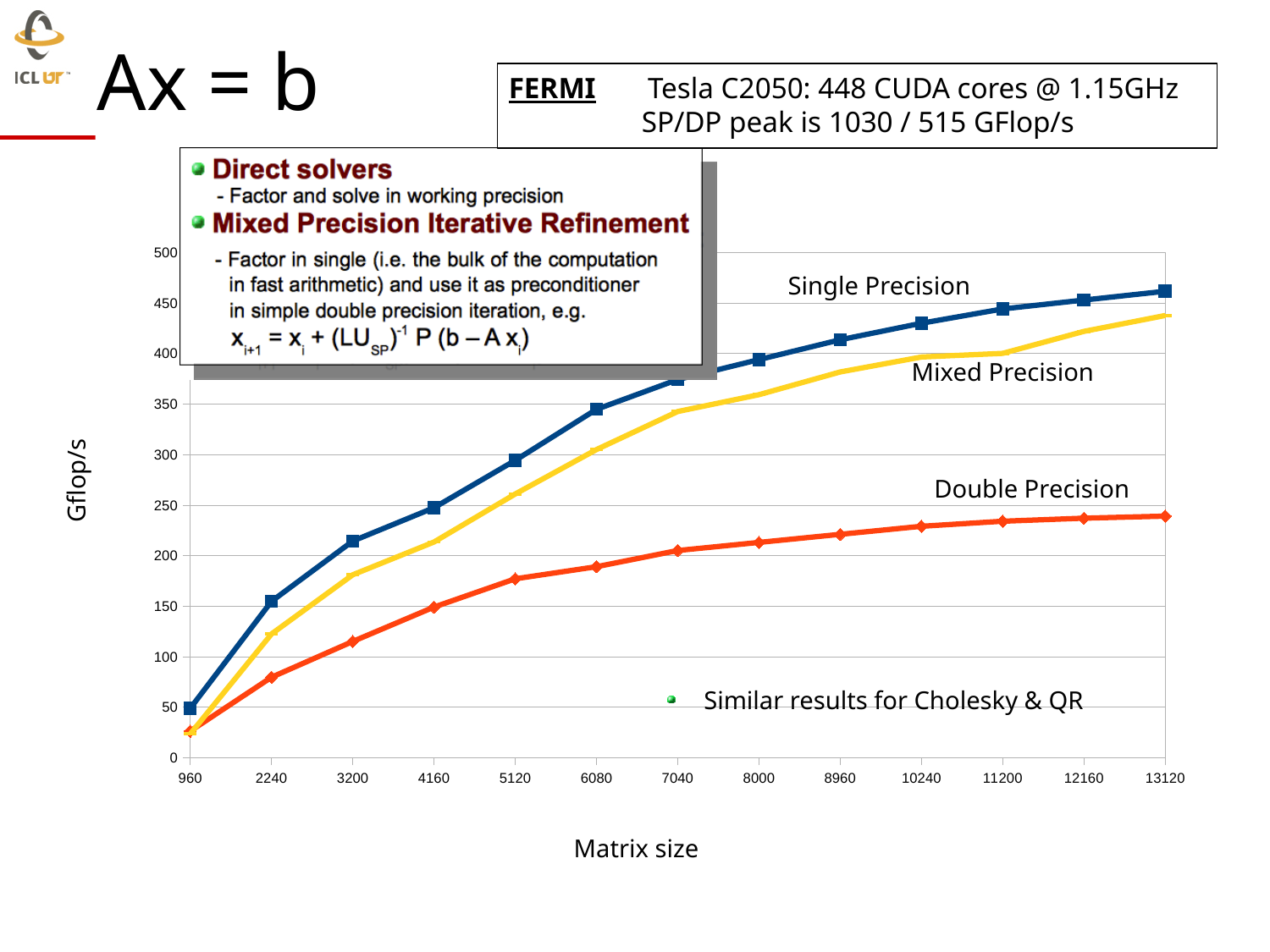
Which series has the lowest Gflop/s at matrix size 13120? Double Precision At matrix size 3200, which is larger: Single Precision or Mixed Precision? Single Precision Is the Single Precision value at matrix size 960 greater or less than 100? less What kind of chart is shown on the slide? line chart Which series has the highest Gflop/s at matrix size 13120? Single Precision How many data series are plotted on the chart? 3 What is the label of the x axis of the chart? Matrix size Is the Double Precision value at matrix size 13120 greater or less than 250? less Does the Double Precision series rise or fall as matrix size increases? rise Is the Mixed Precision value at matrix size 7040 greater or less than 300? greater How many matrix sizes are marked along the x axis of the chart? 13